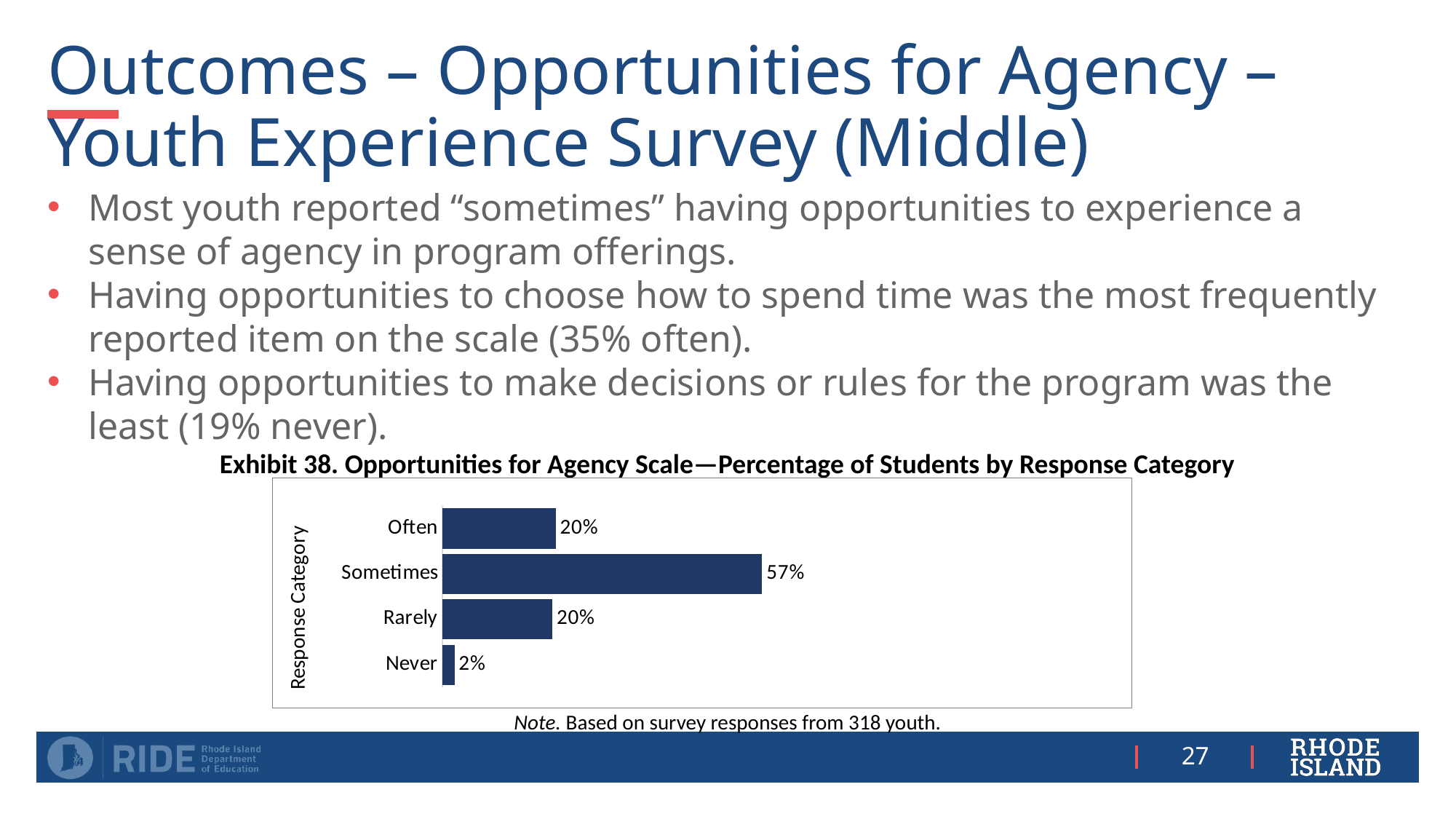
What kind of chart is shown in Exhibit 38? Bar chart Which response category has the lowest percentage of students? Never What percentage of students responded "Sometimes" on the Opportunities for Agency Scale? 57% Which response category has the highest percentage of students? Sometimes How many response categories are shown in the chart? 4 What is the label of the vertical axis in the chart? Response Category Which response category has a larger percentage, "Sometimes" or "Rarely"? Sometimes What percentage of students responded "Often" on the Opportunities for Agency Scale? 20% What percentage of students responded "Rarely" on the Opportunities for Agency Scale? 20% What is the difference in percentage points between the "Rarely" and "Never" response categories? 18 What percentage of students responded "Never" on the Opportunities for Agency Scale? 2% What is the difference in percentage points between the "Sometimes" and "Often" response categories? 37